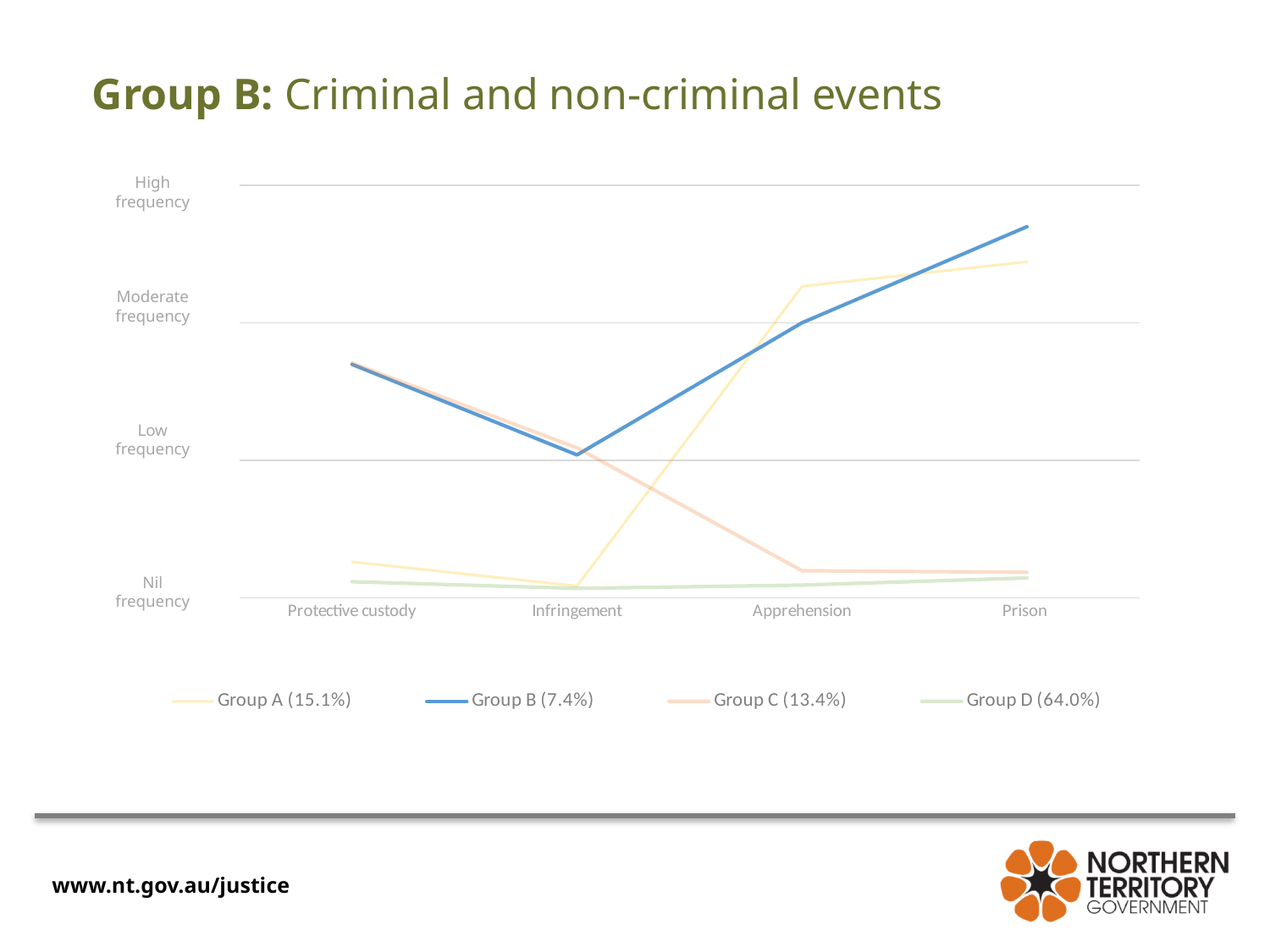
What percentage is shown next to Group D in the legend? 64.0% Does the Group B line rise or fall from Infringement to Prison? Rise What kind of chart is shown on the slide? Line chart At Prison, which is higher: Group B or Group C? Group B For which category does the Group B line reach its highest point? Prison Does the Group C line rise or fall from Protective custody to Apprehension? Fall How many categories are shown on the x axis? 4 At Apprehension, which is higher: Group A or Group B? Group A How many series does the legend list? 4 For which category does the Group B line reach its lowest point? Infringement What is the title of the slide's chart? Group B: Criminal and non-criminal events Is the Group B value at Prison above or below the Moderate frequency line? Above